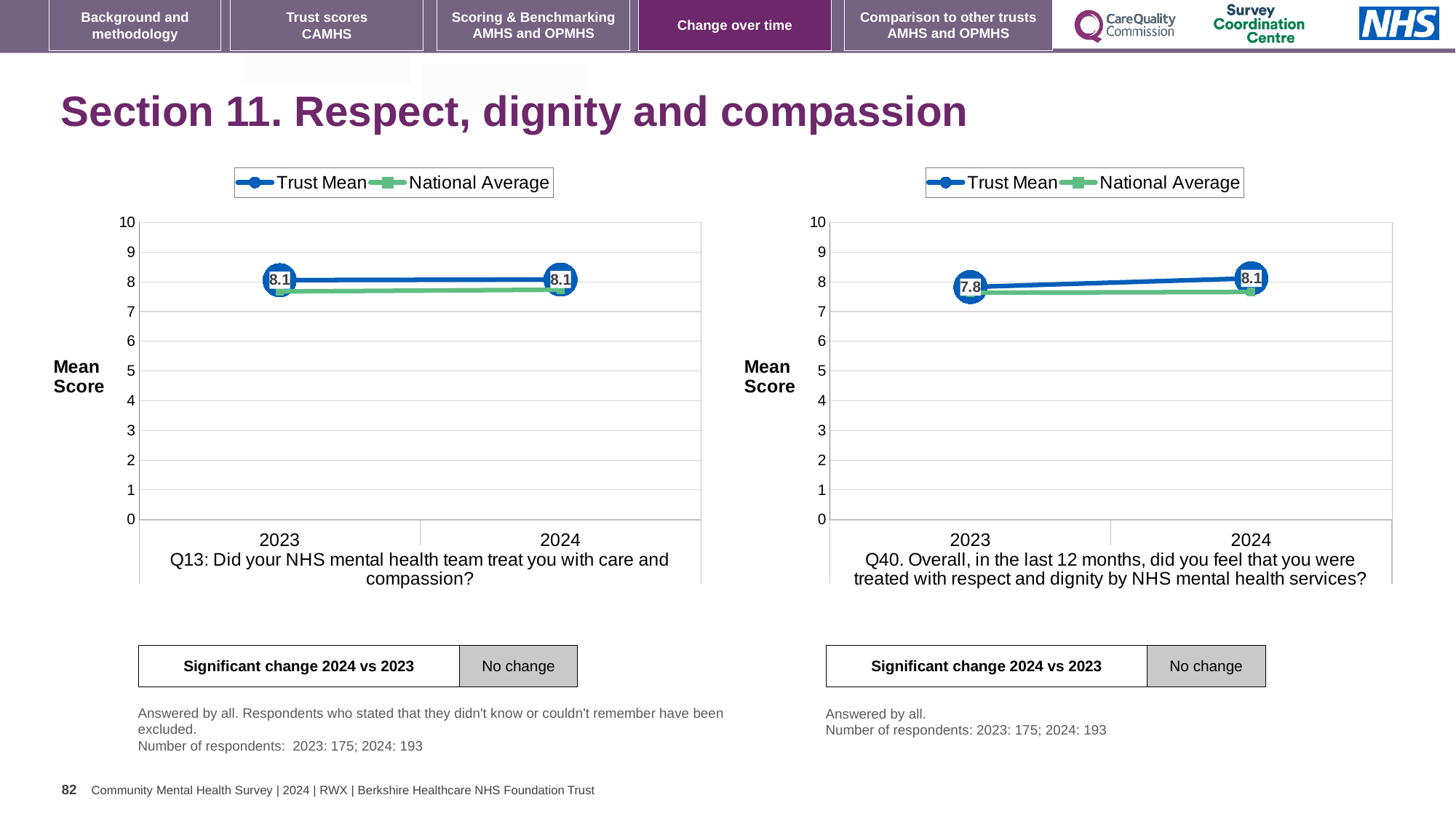
In the left chart (Q13), does the Trust Mean rise, fall or stay the same from 2023 to 2024? stay the same In the right chart (Q40), does the Trust Mean rise or fall from 2023 to 2024? rise In the left chart (Q13), what is the Trust Mean score for 2023? 8.1 In the left chart (Q13), what is the Trust Mean score for 2024? 8.1 In the right chart (Q40), which is larger in 2024, the Trust Mean or the National Average? Trust Mean How many series does the legend of the right chart (Q40) list? 2 In the right chart (Q40), what is the Trust Mean score for 2024? 8.1 How many years are plotted on the x axis of the left chart (Q13)? 2 In the right chart (Q40), by how much did the Trust Mean change from 2023 to 2024? 0.3 What kind of chart is the left chart (Q13)? line chart In the right chart (Q40), what is the Trust Mean score for 2023? 7.8 In the right chart (Q40), is the National Average value for 2024 greater or less than 5? greater